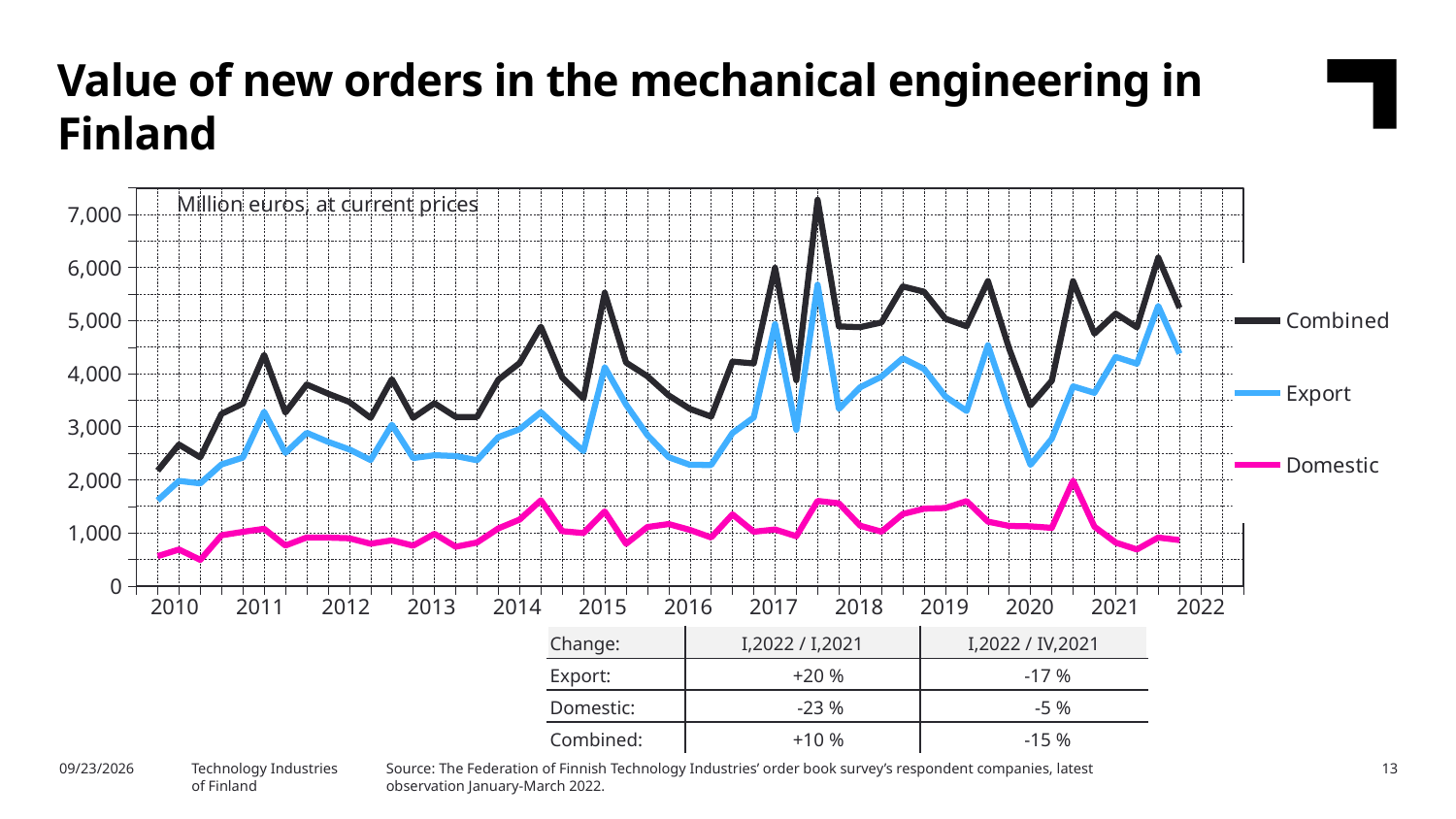
According to the change table, what is the Export change for I,2022 / I,2021? +20 % Which series are listed in the chart's legend? Combined, Export, Domestic What unit is stated for the values in the chart? Million euros, at current prices Is the value of the Export series at the start of 2010 greater or less than 2,000? less Is the value of the Domestic series at the start of 2010 greater or less than 1,000? less Which series has the highest values throughout the chart? Combined Overall, does the Combined series rise or fall from 2010 to 2022? rise According to the change table, what is the Combined change for I,2022 / IV,2021? -15 % Is the peak value of the Combined series in 2017 greater or less than 7,000? greater Which series has the lowest values throughout the chart? Domestic What kind of chart is shown on the slide? Line chart How many series does the chart's legend list? 3